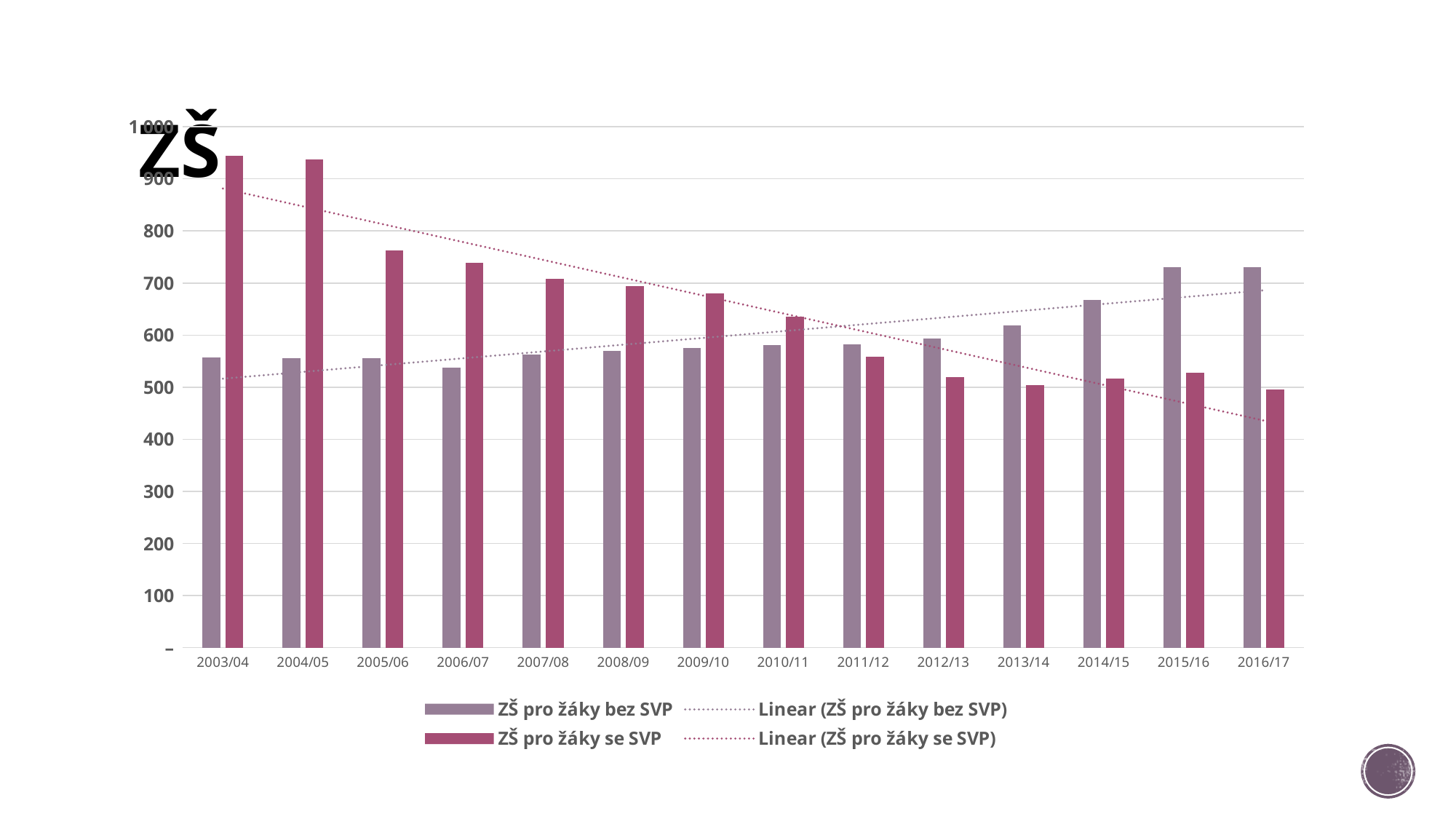
Is the value for ZŠ pro žáky bez SVP in 2006/07 greater or less than 600? less Is the value for ZŠ pro žáky se SVP in 2003/04 greater or less than 900? greater Do the values for ZŠ pro žáky bez SVP generally rise or fall from 2003/04 to 2016/17? rise In 2016/17, which series has the larger value: ZŠ pro žáky bez SVP or ZŠ pro žáky se SVP? ZŠ pro žáky bez SVP What kind of chart is shown on the slide? bar chart How many entries does the legend list? 4 Is the value for ZŠ pro žáky bez SVP in 2015/16 greater or less than 700? greater How many school years are shown on the x axis? 14 Do the values for ZŠ pro žáky se SVP generally rise or fall from 2003/04 to 2016/17? fall What is the title of the chart? ZŠ In 2003/04, which series has the larger value: ZŠ pro žáky bez SVP or ZŠ pro žáky se SVP? ZŠ pro žáky se SVP